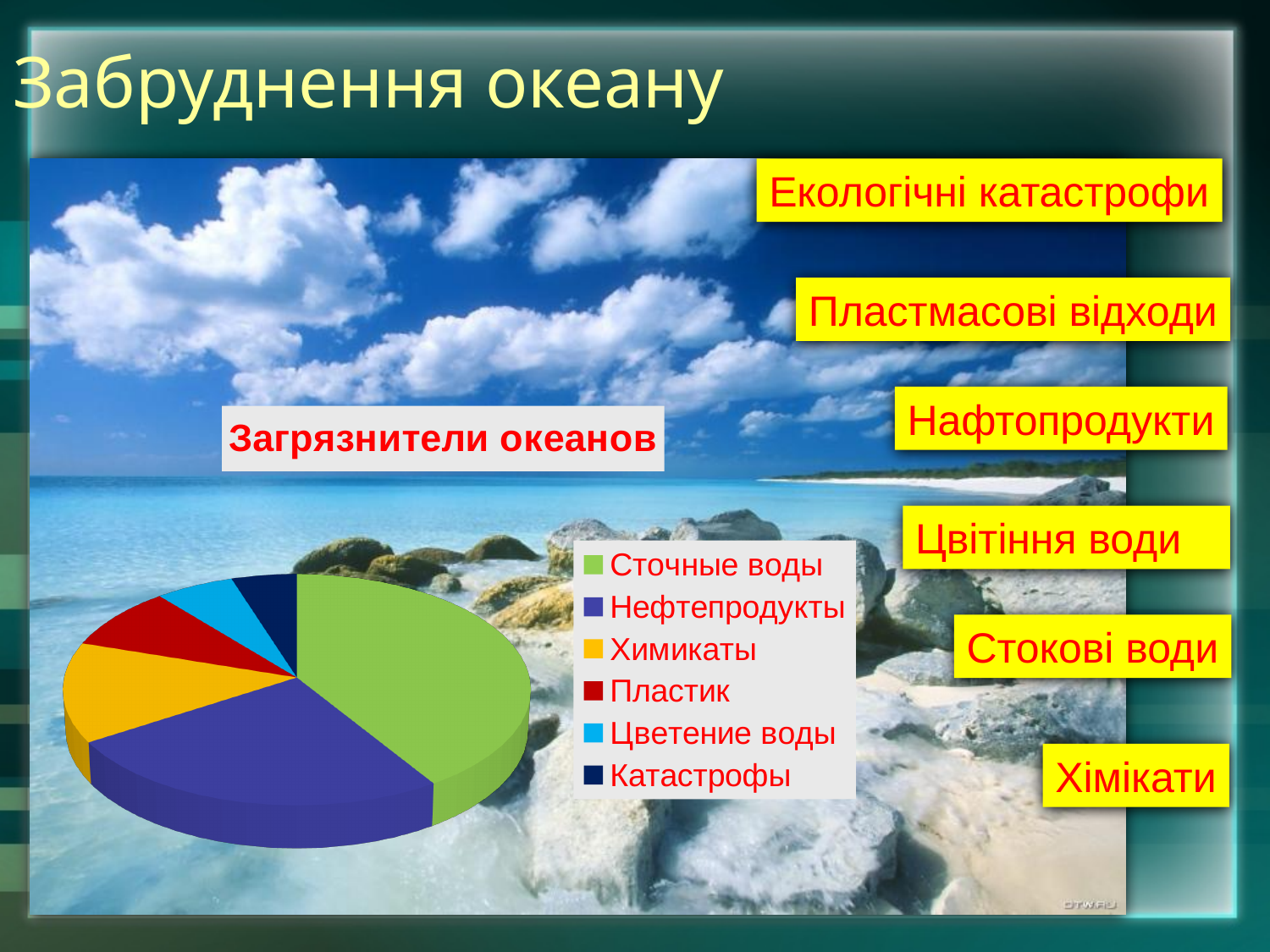
What is the title of the chart? Загрязнители океанов Which slice is larger: Сточные воды or Катастрофы? Сточные воды Which slice is larger: Сточные воды or Нефтепродукты? Сточные воды Which category is shown in green in the pie chart? Сточные воды Which category has the largest slice of the pie? Сточные воды Which slice is larger: Химикаты or Пластик? Химикаты How many entries does the chart legend list? 6 What kind of chart is shown on the slide? pie chart How many categories does the pie chart have? 6